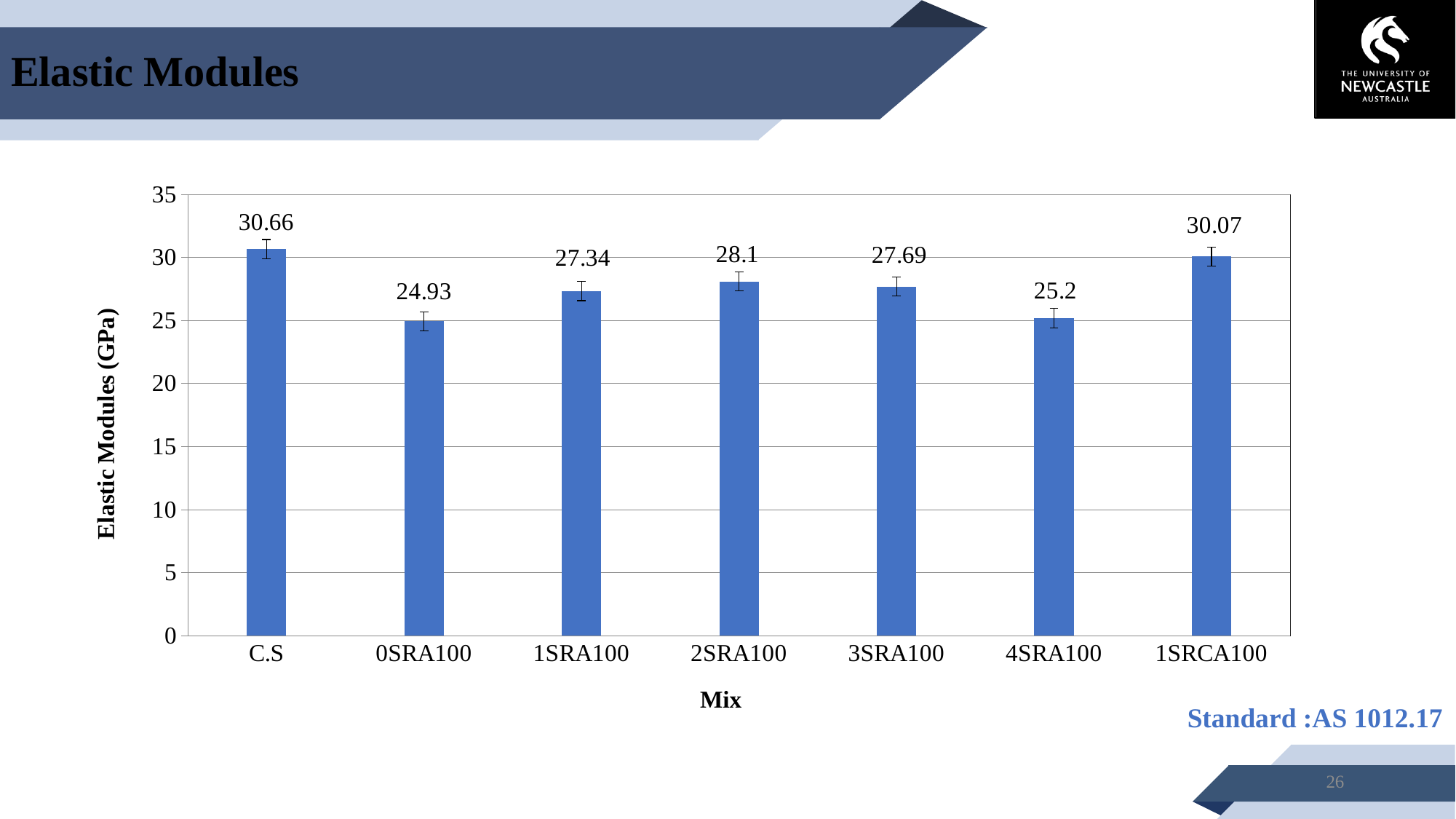
Which has a larger elastic modulus, 1SRA100 or 4SRA100? 1SRA100 How many mixes are shown on the x axis? 7 What is the elastic modulus value for the C.S mix? 30.66 What is the difference between the elastic modulus of 2SRA100 and 1SRA100? 0.76 Which mix has the lowest elastic modulus? 0SRA100 What is the elastic modulus value for the 2SRA100 mix? 28.1 What is the label of the y axis? Elastic Modules (GPa) Is the value for 3SRA100 greater or less than 25? greater Which mix has the highest elastic modulus? C.S What kind of chart is shown on the slide? Bar chart What is the elastic modulus value for the 4SRA100 mix? 25.2 What is the difference between the elastic modulus of C.S and 0SRA100? 5.73